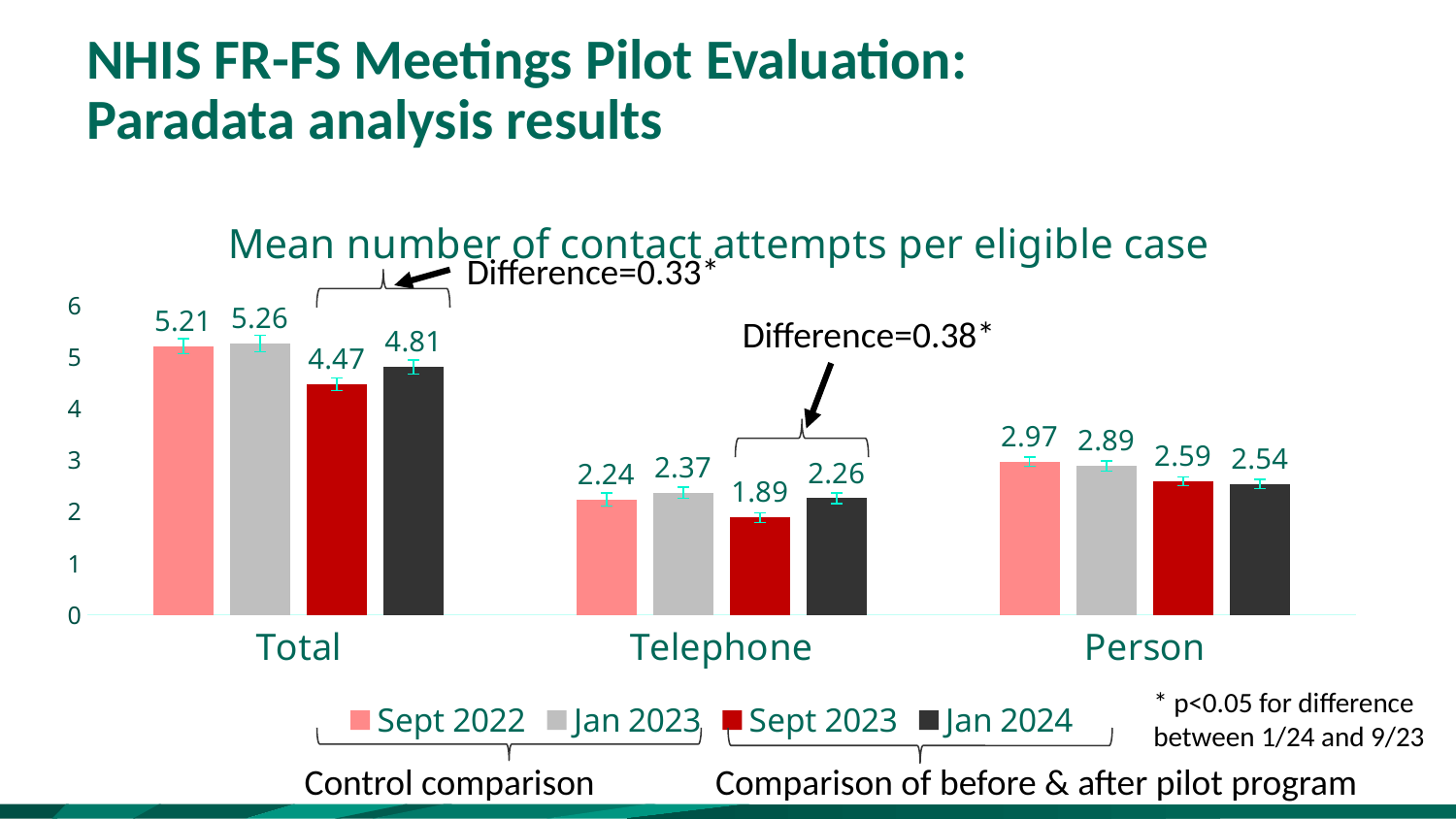
What is the value for Person in Sept 2023? 2.59 What kind of chart is shown on the slide? bar chart Which category has the lowest value for Sept 2023? Telephone What is the value for Telephone in Jan 2024? 2.26 What is the title of the chart? Mean number of contact attempts per eligible case How many series does the legend list? 4 How many categories are shown on the x axis? 3 Which is larger for Person: the Sept 2022 value or the Jan 2024 value? Sept 2022 Is the value for Telephone in Sept 2023 greater or less than 2? less What is the mean number of contact attempts per eligible case for Total in Sept 2022? 5.21 Which category has the highest value for Jan 2023? Total